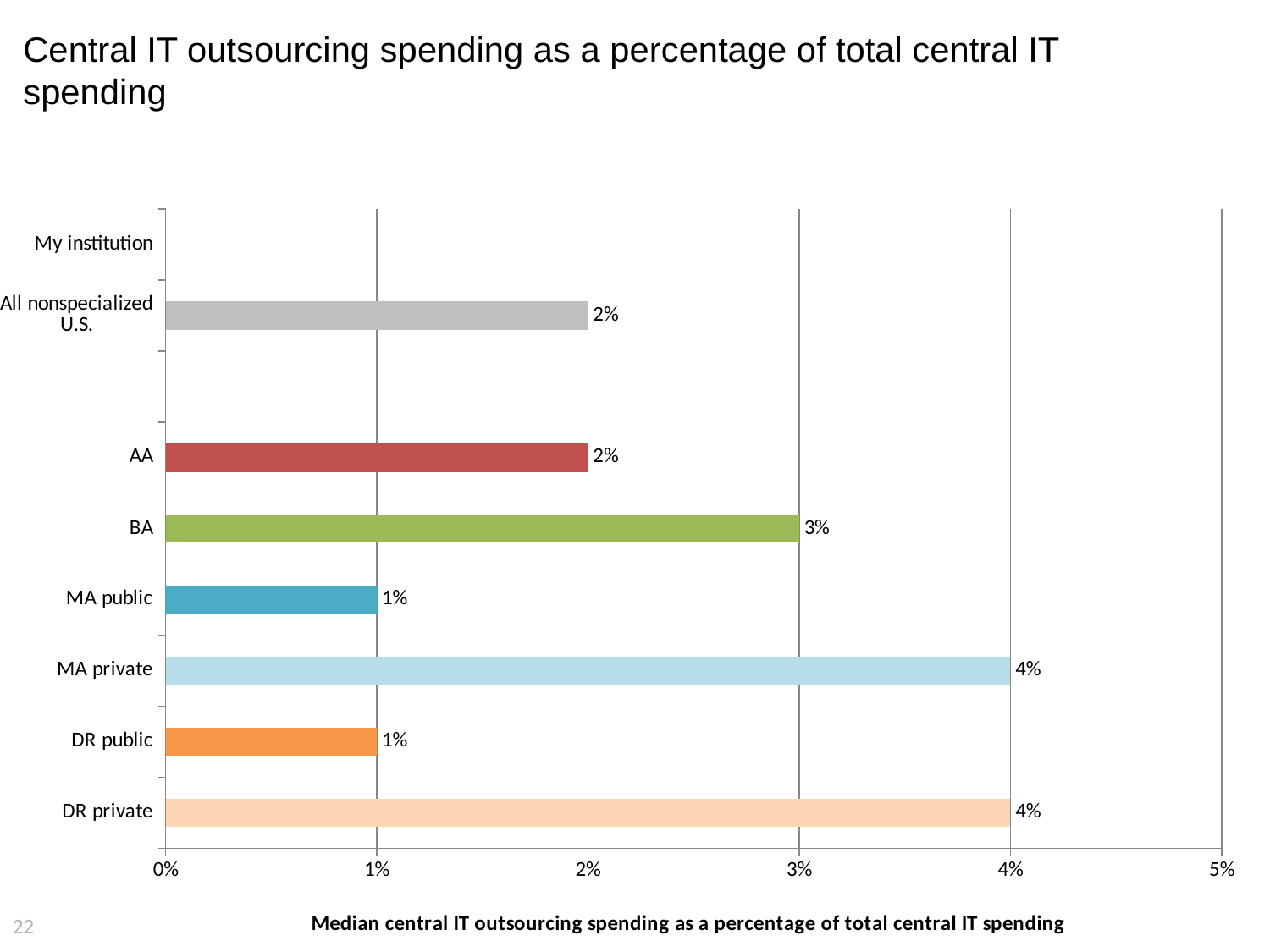
What is the value for DR public? 1% Is the value for DR private greater or less than 3%? greater What is the value for MA private? 4% What is the title of the horizontal axis of the chart? Median central IT outsourcing spending as a percentage of total central IT spending What is the value for AA? 2% What is the value for BA? 3% What is the difference between the values for BA and AA? 1% Which is larger, the value for BA or the value for AA? BA What is the value for All nonspecialized U.S.? 2% What is the difference between the values for MA private and MA public? 3% Which is larger, the value for MA public or the value for MA private? MA private What kind of chart is shown on the slide? Bar chart